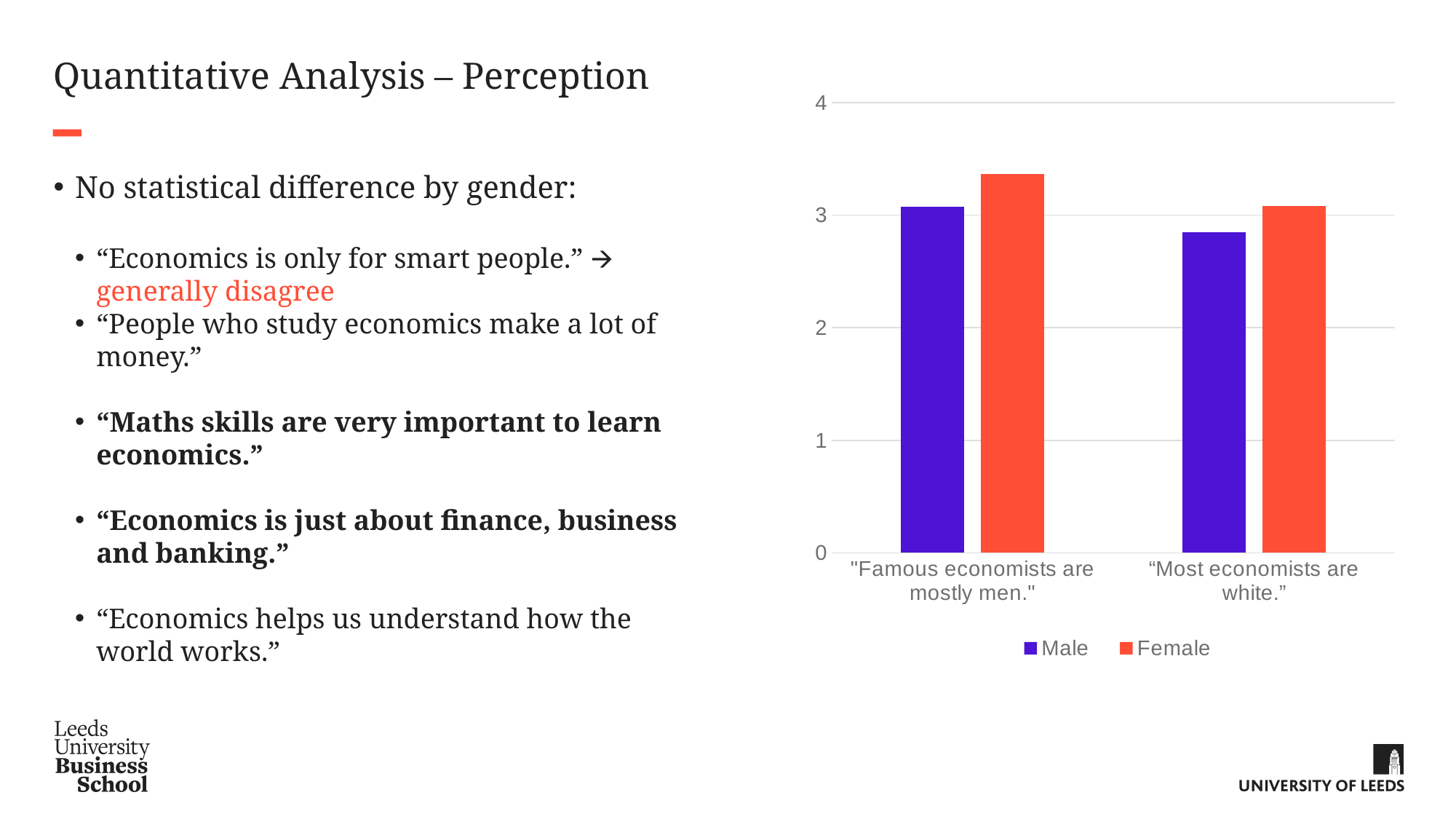
What is the highest value shown on the chart's vertical axis? 4 Is the Female value for "Famous economists are mostly men." greater or less than 3? greater Which bar is the tallest in the chart? Female for "Famous economists are mostly men." What kind of chart is shown on the slide? bar chart What colour represents the Female series in the chart? orange-red How many series does the chart's legend list? 2 Which bar is the shortest in the chart? Male for "Most economists are white." Which series has the higher value for "Most economists are white.", Male or Female? Female Is the Male value for "Most economists are white." greater or less than 3? less How many categories are shown on the x axis of the chart? 2 Is the Male value for "Famous economists are mostly men." greater or less than 2? greater Which series has the higher value for "Famous economists are mostly men.", Male or Female? Female